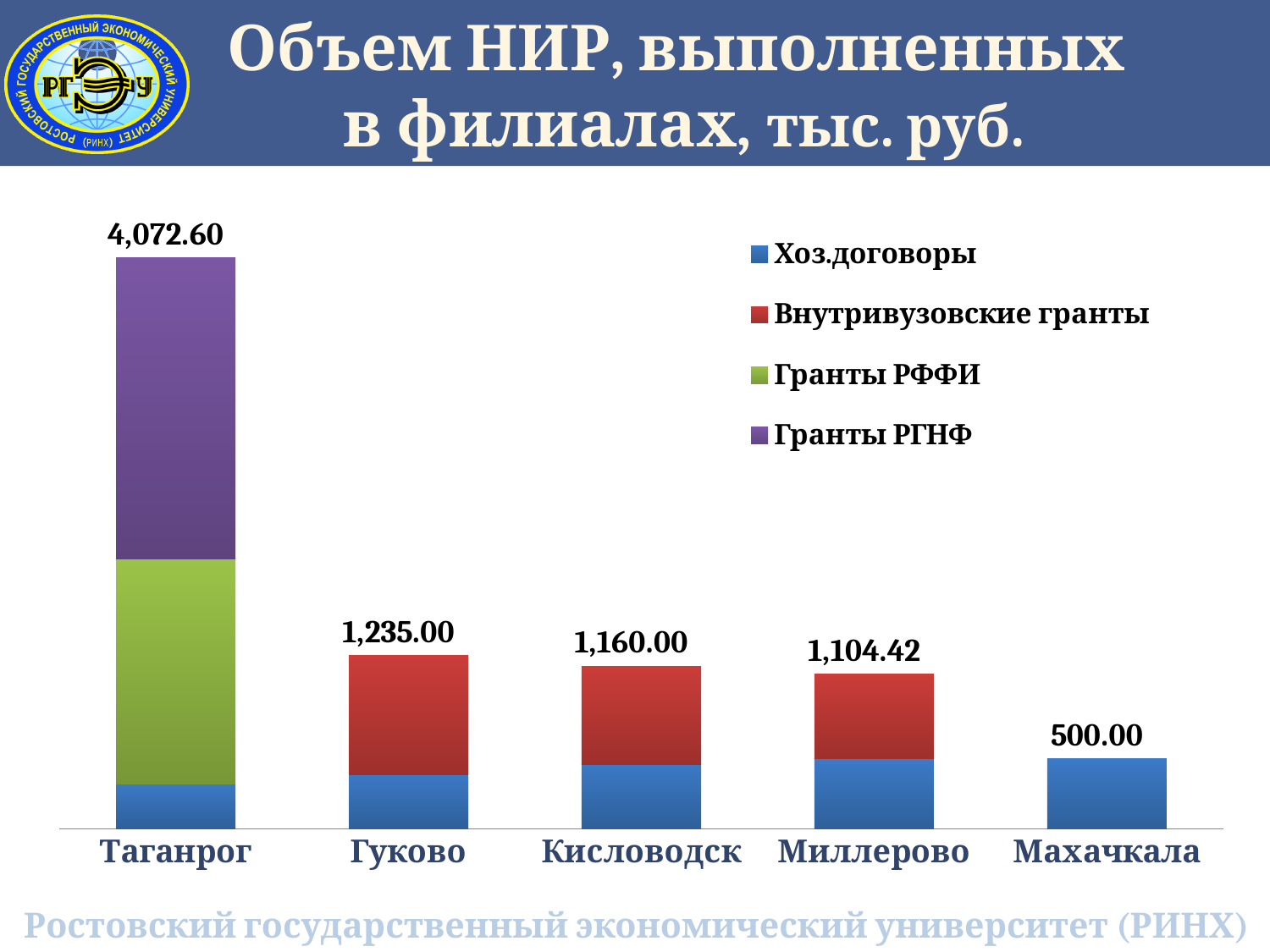
What is the difference between the totals for Гуково and Кисловодск? 75.00 What is the total value shown above the bar for Таганрог? 4,072.60 Which branch has the highest total volume of research work? Таганрог How many series does the legend list? 4 What is the difference between the totals for Таганрог and Махачкала? 3,572.60 What is the total value shown above the bar for Миллерово? 1,104.42 How many branches are shown on the x axis? 5 What is the total value shown above the bar for Гуково? 1,235.00 What is the total value shown above the bar for Махачкала? 500.00 Which has a larger total, Кисловодск or Миллерово? Кисловодск Which branch has the lowest total volume of research work? Махачкала What kind of chart is shown on the slide? Stacked bar chart